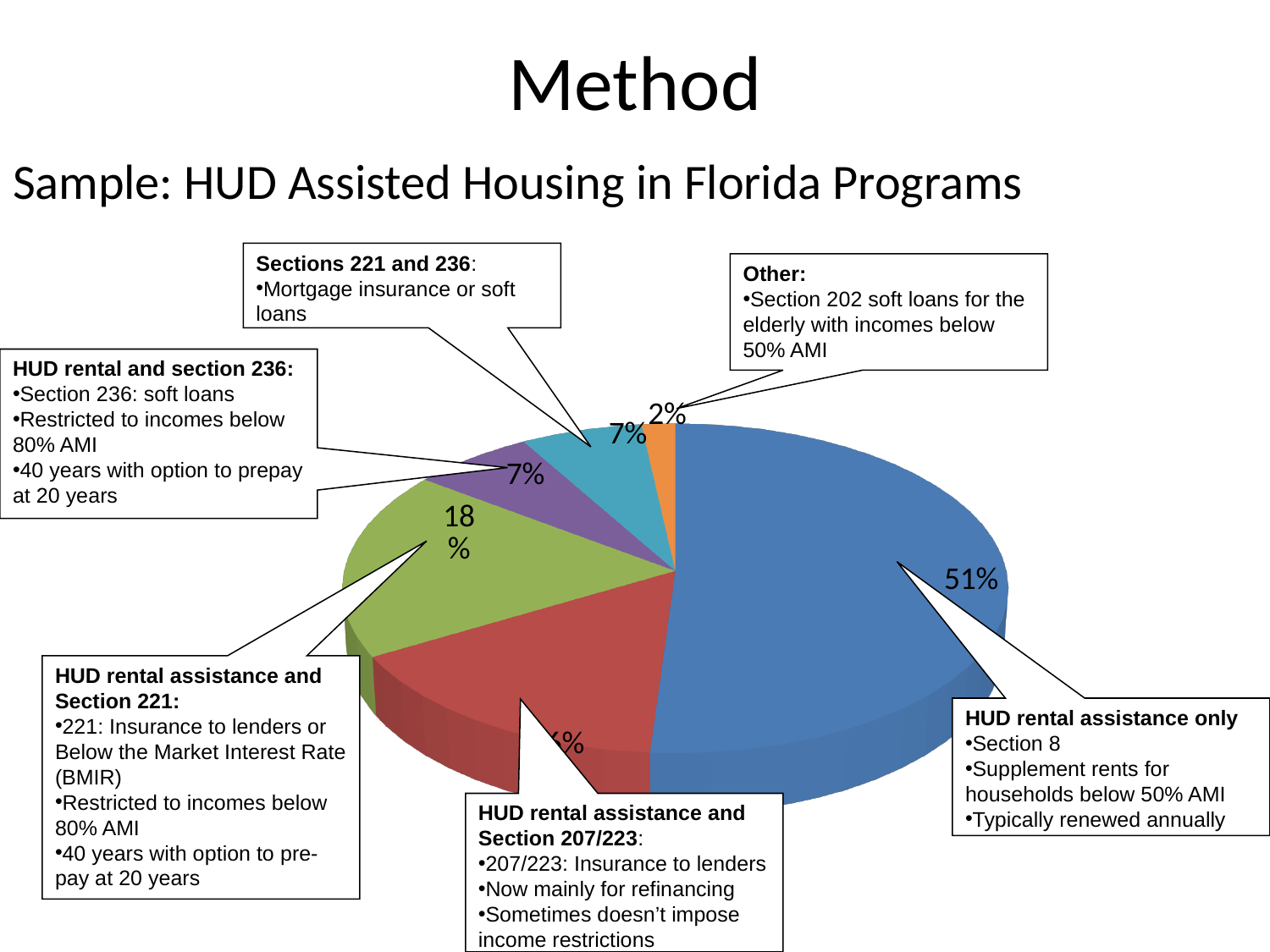
Which category has the largest slice of the pie? HUD rental assistance only What share of the pie does HUD rental assistance only represent? 51% How many percentage points larger is the HUD rental assistance only slice than the HUD rental assistance and Section 221 slice? 33 percentage points What share of the pie does HUD rental assistance and Section 221 represent? 18% What kind of chart is shown on the slide? Pie chart What share of the pie does Sections 221 and 236 represent? 7% Which category has the smallest slice of the pie? Other How many slices does the pie chart have? 6 What colour is the slice for HUD rental assistance only? Blue Which is larger: the slice for HUD rental assistance and Section 221 or the slice for Other? HUD rental assistance and Section 221